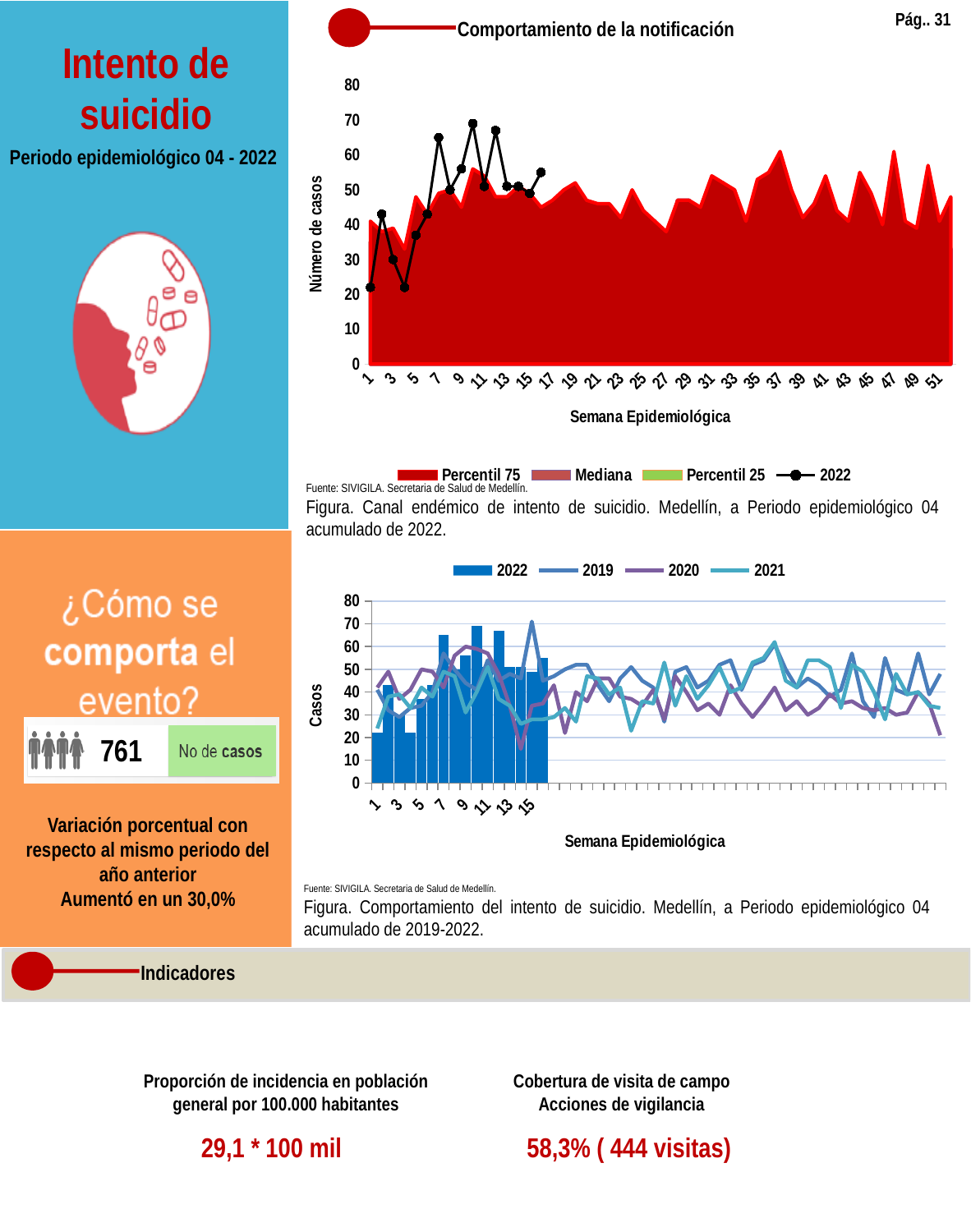
In the top chart (Comportamiento de la notificación), how many series does the legend list? 4 In the top chart, what is the label of the vertical axis? Número de casos In the top chart, is the lowest value of the 2022 line greater or less than 30? less In the bottom chart, is the shortest 2022 bar greater or less than 30? less In the bottom chart (Comportamiento del intento de suicidio), how many series does the legend list? 4 In the bottom chart, is the tallest 2022 bar greater or less than 60? greater In the bottom chart, which series is drawn as bars rather than a line? 2022 In the top chart, what is the highest value shown on the vertical axis? 80 In the top chart, does the 2022 line overall rise or fall from week 1 to its peak around week 9? rise